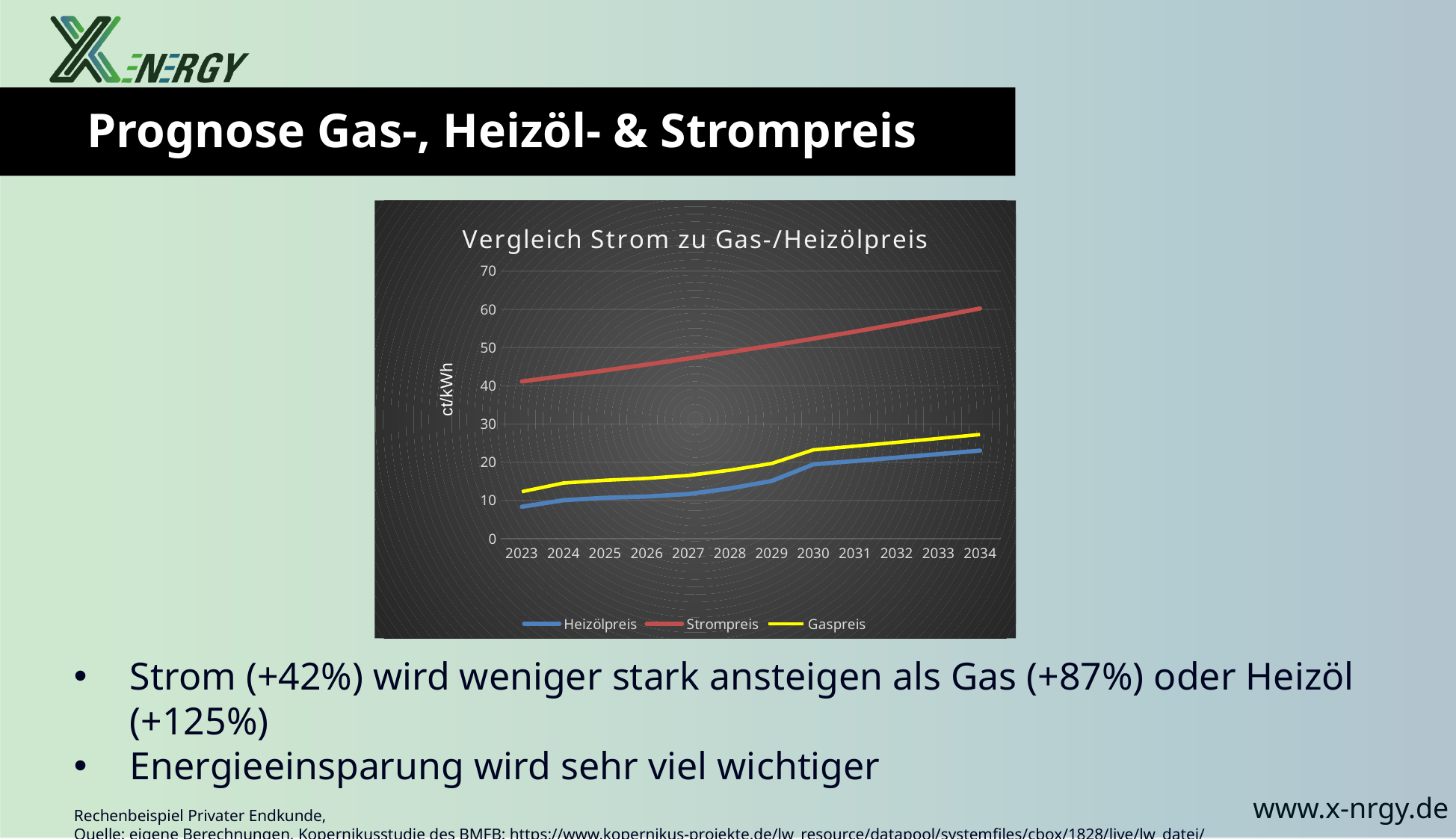
Is the value for Gaspreis in 2034 greater or less than 20? greater Which is larger in 2030, Strompreis or Gaspreis? Strompreis Does the Strompreis line rise or fall from 2023 to 2034? rise Which series has the highest value in 2034? Strompreis How many years are shown on the x axis of the chart? 12 Is the value for Strompreis in 2034 greater or less than 50? greater What kind of chart is shown on the slide? line chart What unit is shown on the y axis of the chart? ct/kWh Is the value for Heizölpreis in 2023 greater or less than 10? less How many series does the chart legend list? 3 Which series has the lowest value in 2023? Heizölpreis